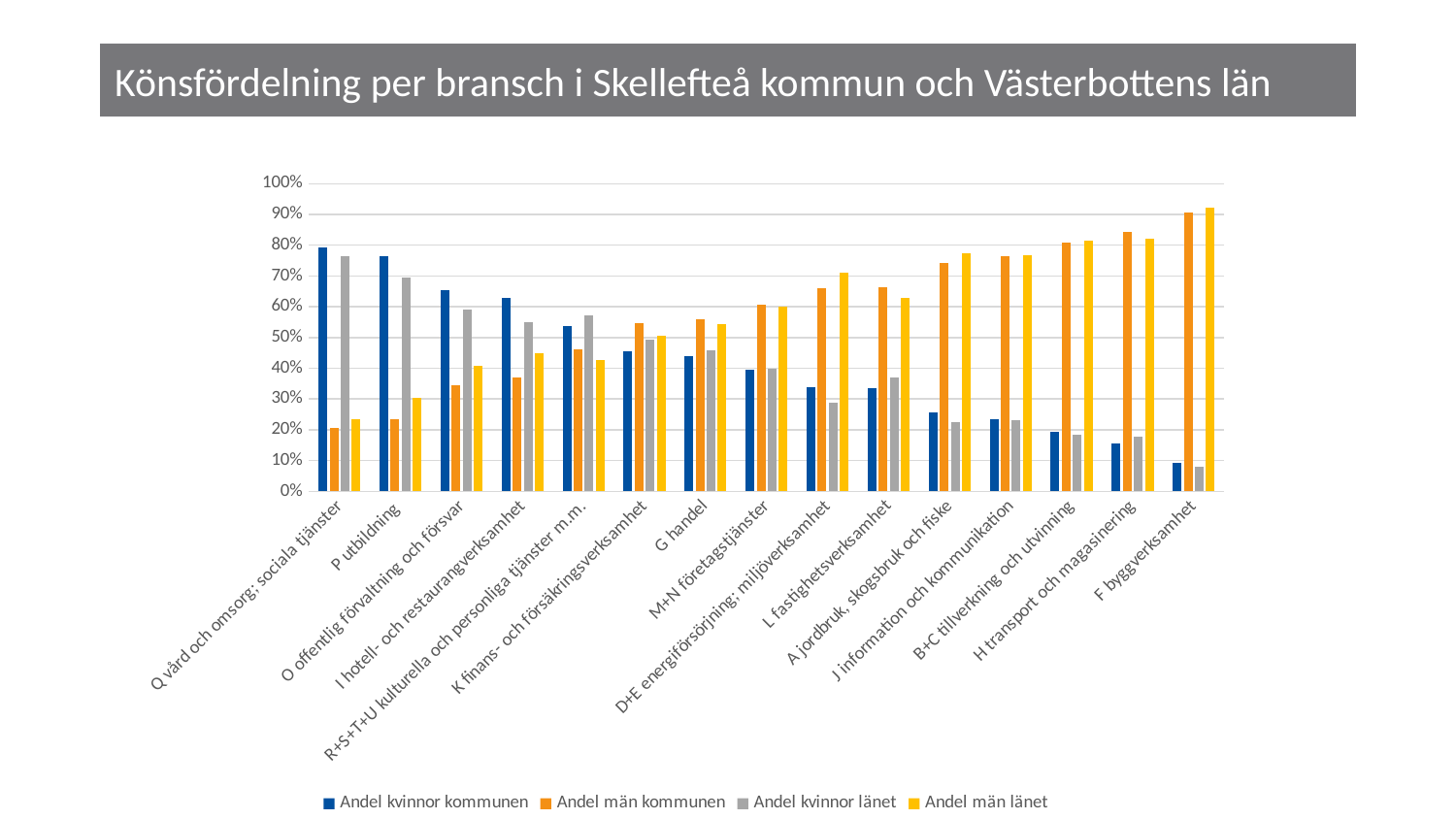
How many series does the legend list? 4 Which category has the highest value for Andel män kommunen? F byggverksamhet Is the value for Andel kvinnor länet in O offentlig förvaltning och försvar greater or less than 50%? greater Is the value for Andel män kommunen in P utbildning greater or less than 30%? less Which category has the lowest value for Andel kvinnor kommunen? F byggverksamhet What kind of chart is shown on the slide? bar chart Do the values for Andel män kommunen generally rise or fall from left to right along the x axis? rise Is the value for Andel kvinnor kommunen in Q vård och omsorg; sociala tjänster greater or less than 70%? greater What is the title of the chart? Könsfördelning per bransch i Skellefteå kommun och Västerbottens län How many industry categories are shown on the x axis? 15 For G handel, which is larger: Andel kvinnor kommunen or Andel män kommunen? Andel män kommunen